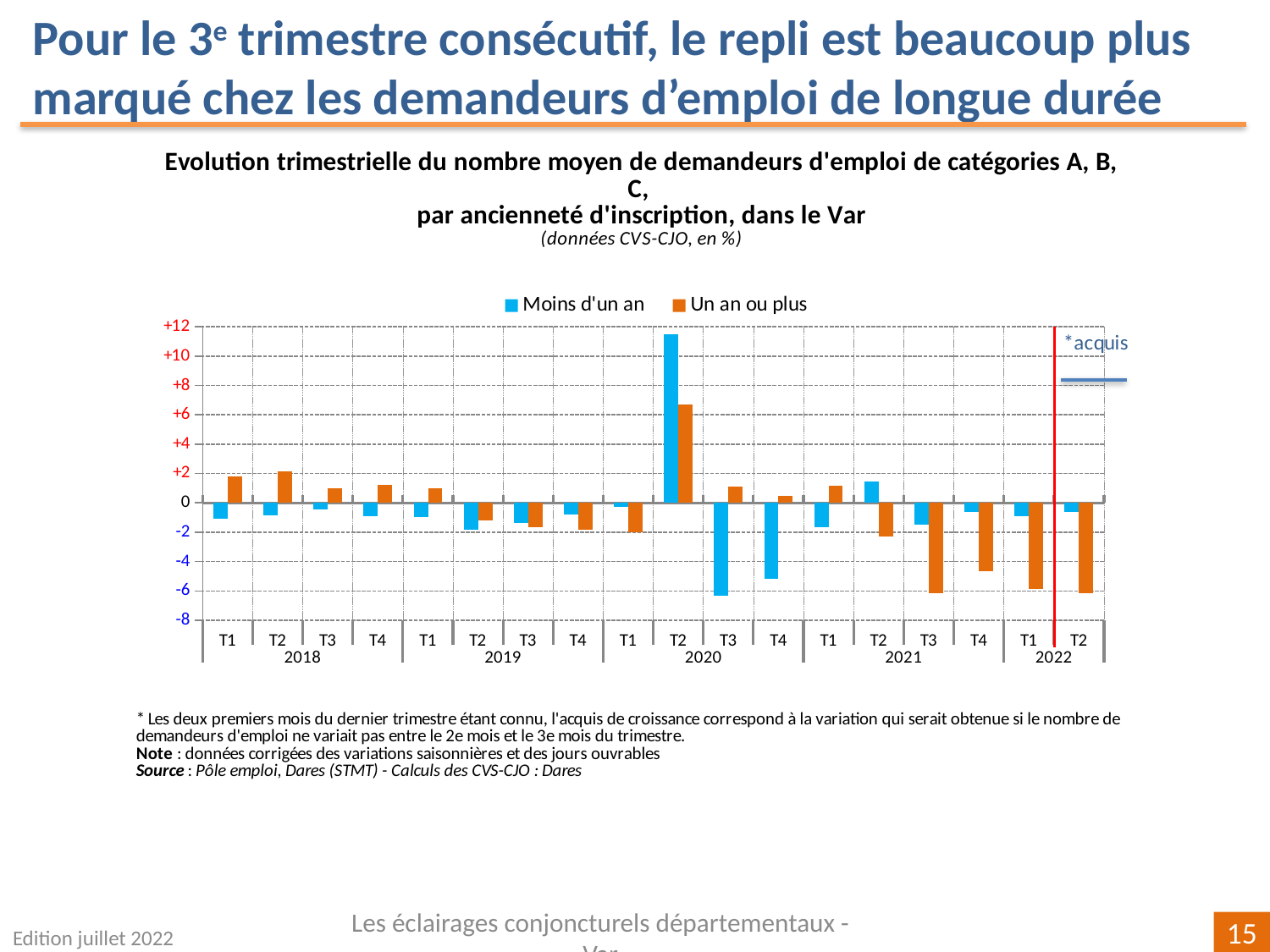
Is the value for 'Un an ou plus' in T2 2020 greater or less than +4? greater What are the two series named in the legend? Moins d'un an; Un an ou plus In which quarter is the value for 'Un an ou plus' highest? T2 2020 What kind of chart is shown on the slide? Bar chart In which quarter is the value for 'Moins d'un an' lowest? T3 2020 How many series does the legend list? 2 In which quarter is the value for 'Moins d'un an' highest? T2 2020 Is the value for 'Un an ou plus' in T1 2022 greater or less than -4? less In T3 2021, which series has the lower value, 'Moins d'un an' or 'Un an ou plus'? Un an ou plus Is the value for 'Moins d'un an' in T2 2020 greater or less than +10? greater How many quarters are plotted along the x axis? 18 In T2 2020, which series has the larger value, 'Moins d'un an' or 'Un an ou plus'? Moins d'un an